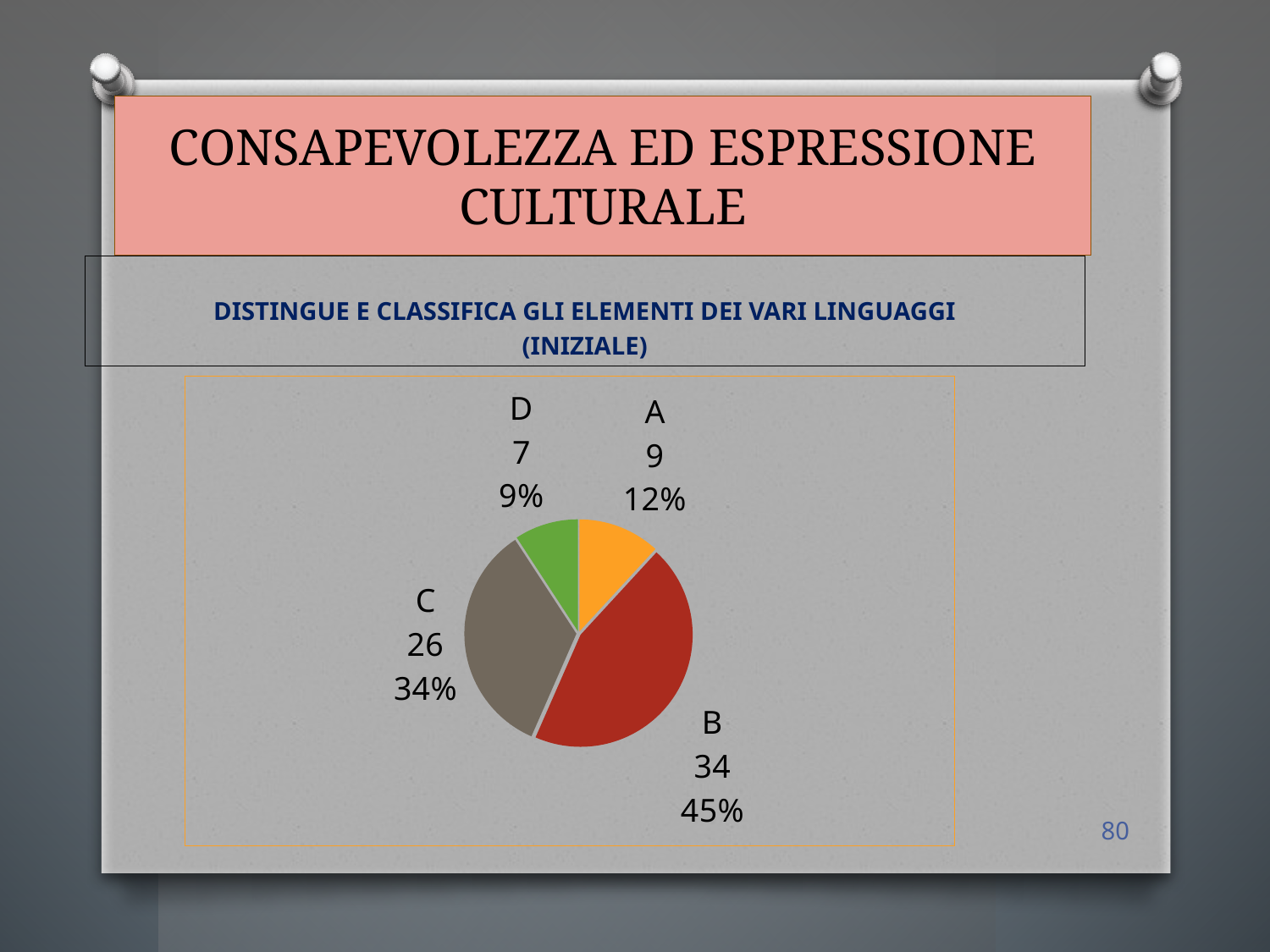
What is the value for category B? 34 What share of the pie does category A represent? 12% What kind of chart is shown on the slide? pie chart Which category has the smallest slice? D Which is larger, the value for A or the value for D? A What is the value for category A? 9 What is the difference between the values for B and C? 8 What is the value for category C? 26 What share of the pie does category C represent? 34% What is the value for category D? 7 Which category has the largest slice? B How many categories are shown in the pie chart? 4